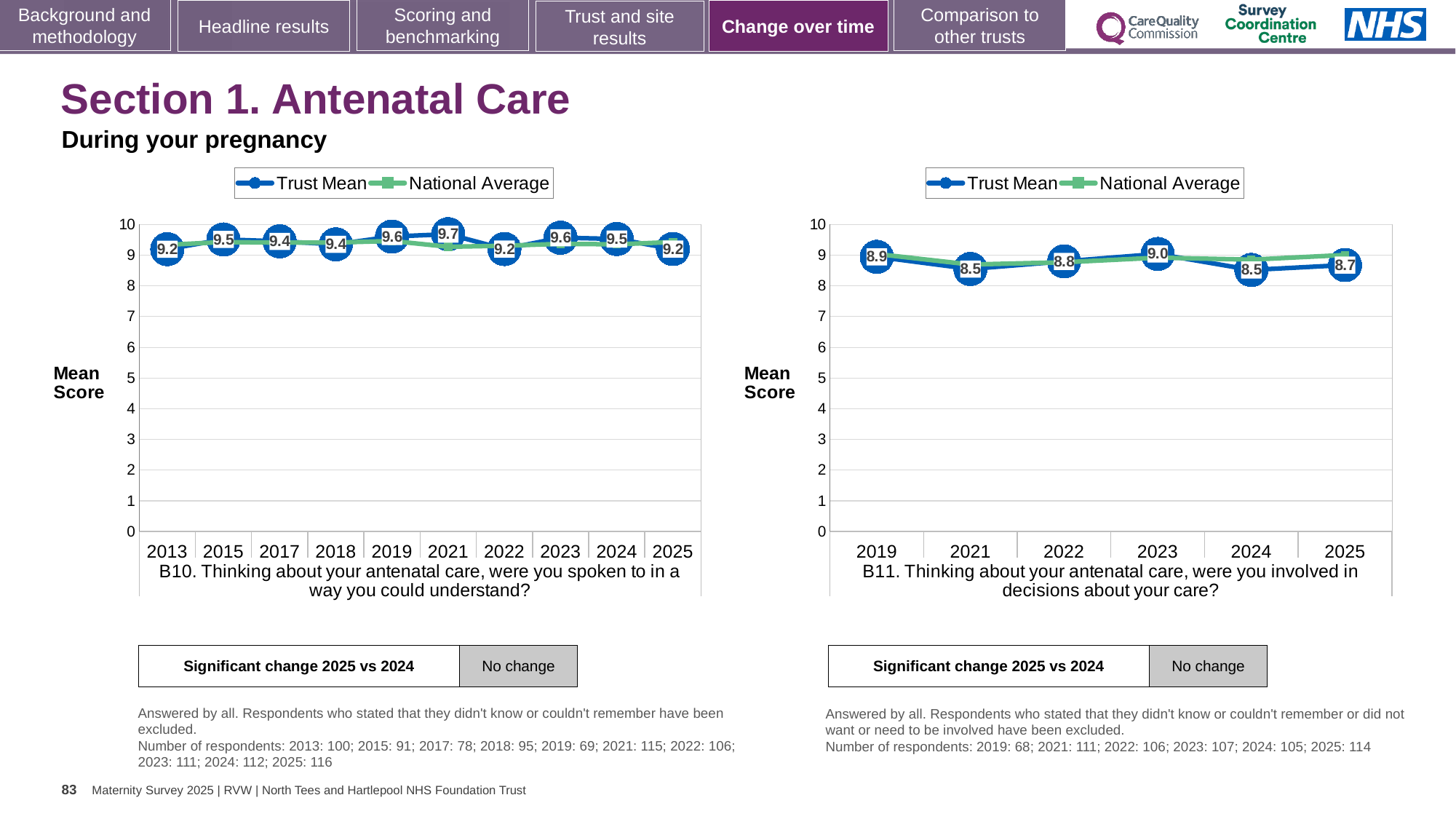
What kind of chart is the B10 chart on the left? Line chart In the B11 chart on the right, which year has the highest Trust Mean score? 2023 How many series does the legend of the B11 chart on the right list? 2 In the B11 chart on the right, which year has the larger Trust Mean score, 2019 or 2021? 2019 In the B10 chart on the left, what is the difference between the Trust Mean scores for 2021 and 2025? 0.5 In the B10 chart on the left, what is the Trust Mean score for 2021? 9.7 In the B11 chart on the right, what is the Trust Mean score for 2025? 8.7 In the B11 chart on the right, what is the Trust Mean score for 2023? 9.0 In the B10 chart on the left, what is the Trust Mean score for 2013? 9.2 In the B11 chart on the right, is the National Average value for 2025 greater or less than 8? greater How many years are shown on the x axis of the B10 chart on the left? 10 In the B10 chart on the left, which year has the highest Trust Mean score? 2021